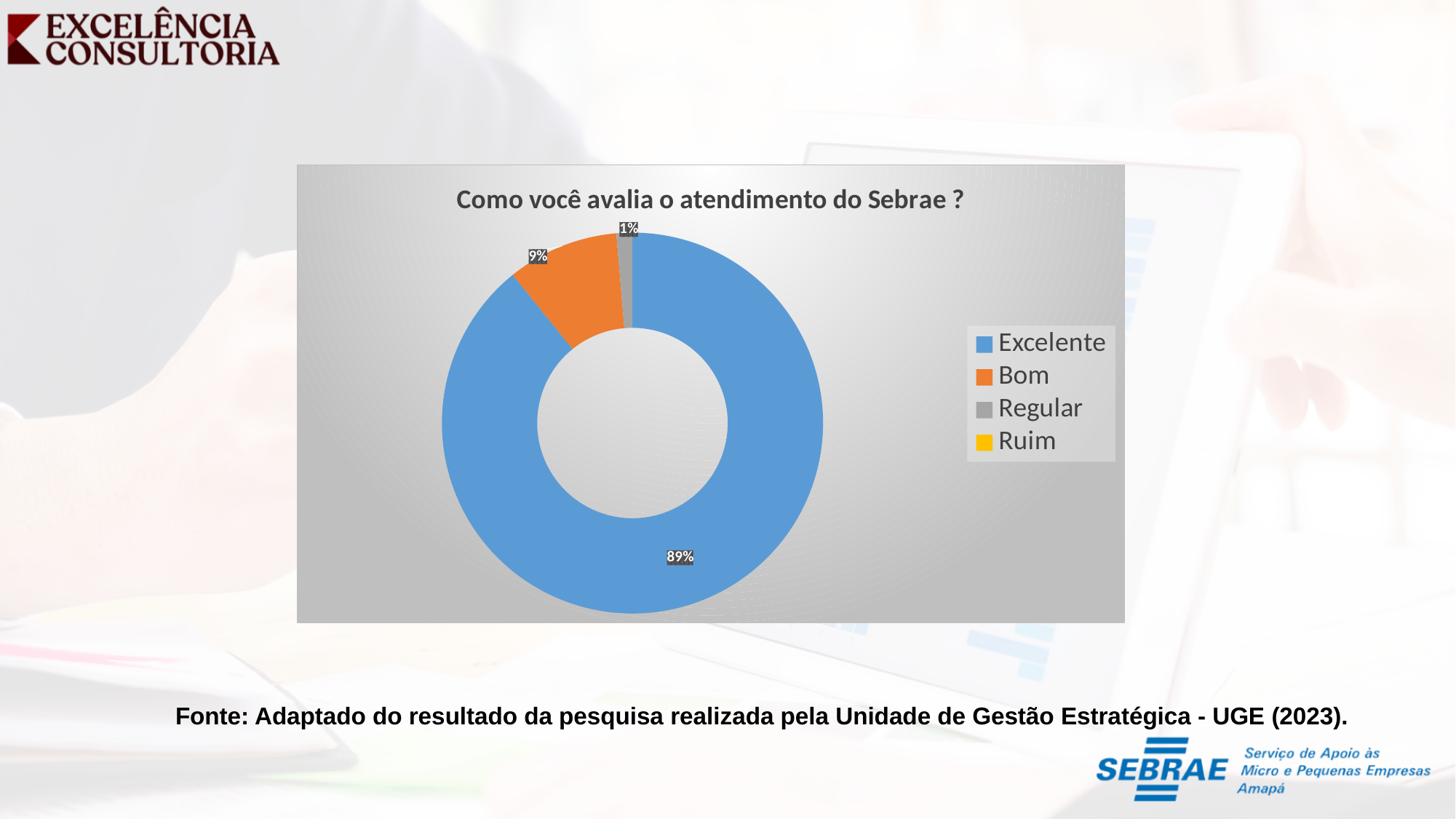
What percentage of respondents rated Sebrae's service as Regular? 1% Which category has the largest share of the chart? Excelente What is the difference in percentage points between the Excelente and Bom shares? 80 What is the title of the chart? Como você avalia o atendimento do Sebrae ? What percentage of respondents rated Sebrae's service as Excelente? 89% Is the share for Excelente greater or less than 50%? greater What kind of chart is shown on the slide? Doughnut (pie) chart How many categories does the legend list? 4 Which colour represents the Bom category in the chart? Orange What percentage of respondents rated Sebrae's service as Bom? 9% Which share is larger, Bom or Regular? Bom